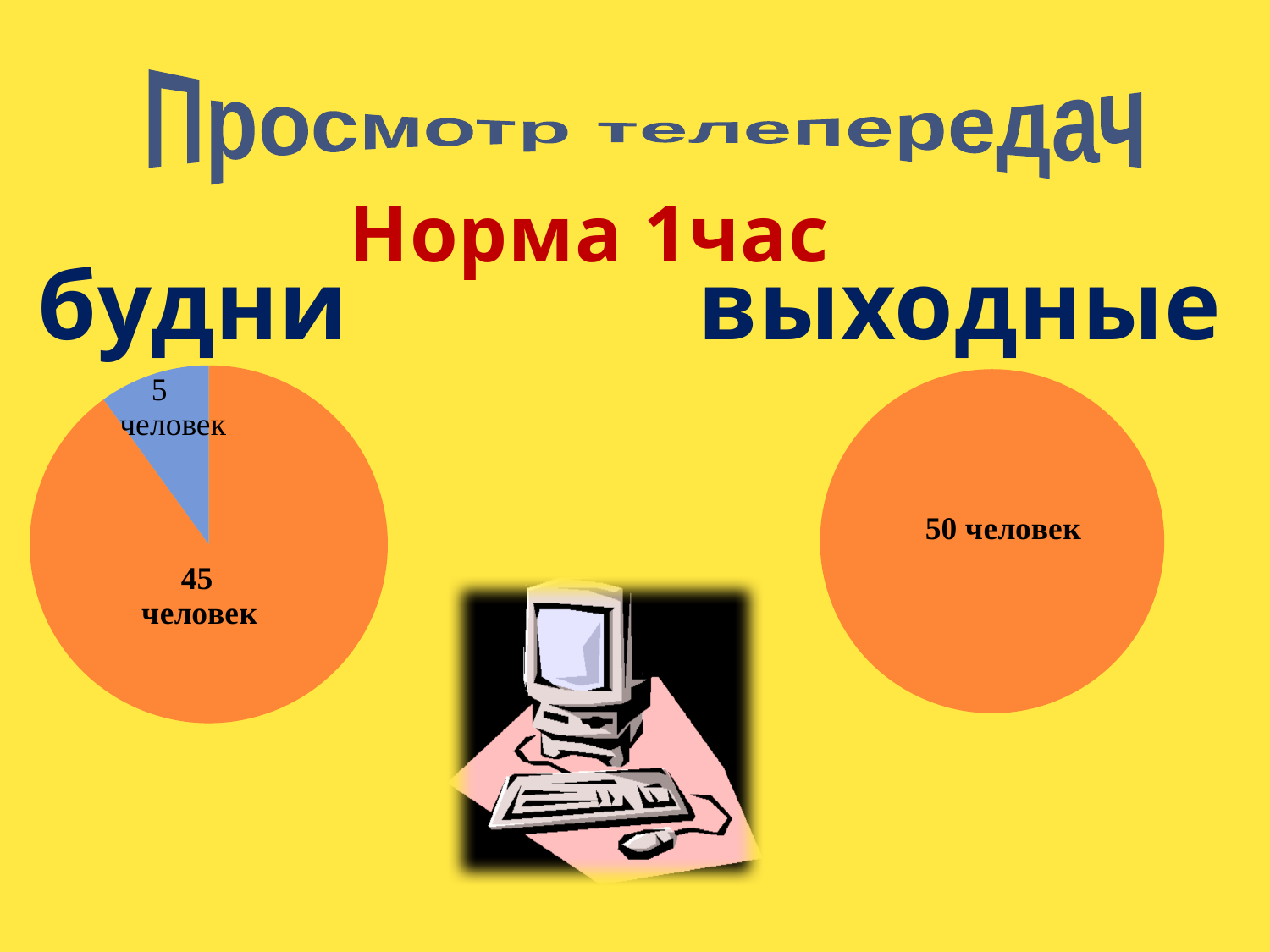
In the "будни" pie chart, what is the total of the two slices? 50 человек How many slices does the "будни" pie chart have? 2 In the "будни" pie chart, what share of the whole pie is the orange slice (45 человек)? 90% In the "выходные" pie chart, what value is printed on the pie? 50 человек What kind of chart is shown under the heading "будни"? pie chart In the "будни" pie chart, what value is printed on the orange slice? 45 человек How many slices does the "выходные" pie chart have? 1 In the "будни" pie chart, what is the difference between the orange slice (45 человек) and the blue slice (5 человек)? 40 человек In the "будни" pie chart, which slice is larger, the orange one or the blue one? the orange one What is the title written at the top of the slide above the two pie charts? Просмотр телепередач In the "будни" pie chart, what share of the whole pie is the blue slice (5 человек)? 10% In the "будни" pie chart, what value is printed on the blue slice? 5 человек